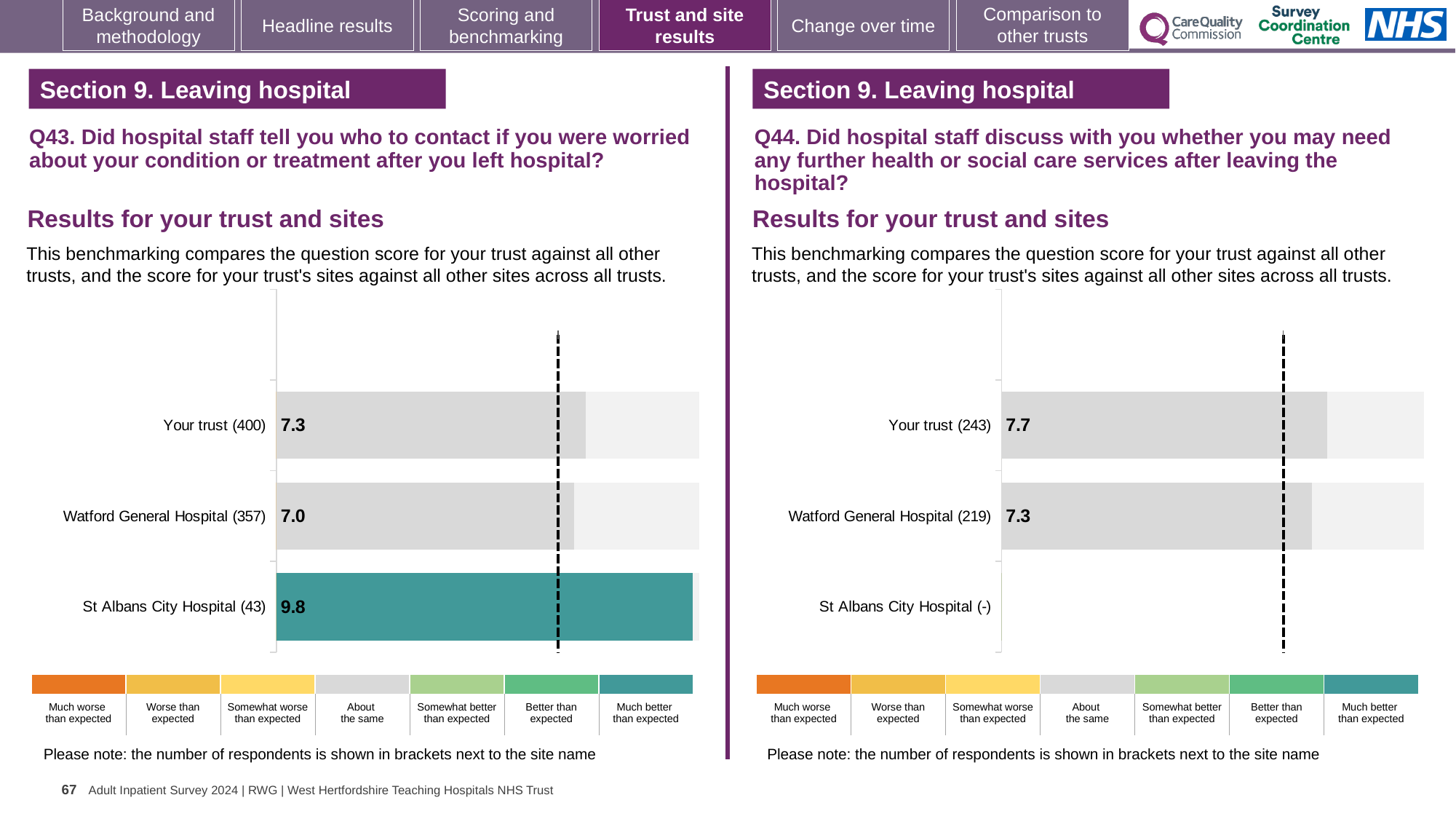
In the Q44 chart on the right, what is the score for Your trust? 7.7 In the Q43 chart on the left, how many bars are plotted? 3 In the Q44 chart on the right, what is the score for Watford General Hospital? 7.3 In the Q43 chart on the left, what is the score for Your trust? 7.3 In the Q43 chart on the left, what is the difference between the St Albans City Hospital score and the Watford General Hospital score? 2.8 In the Q43 chart on the left, what is the score for St Albans City Hospital? 9.8 In the Q43 chart on the left, which site or trust has the highest score? St Albans City Hospital In the Q44 chart on the right, which is larger, the score for Your trust or the score for Watford General Hospital? Your trust In the Q43 chart on the left, what is the score for Watford General Hospital? 7.0 In the Q43 chart on the left, which site or trust has the lowest score? Watford General Hospital What type of chart is used in the Q43 chart on the left? Bar chart In the Q44 chart on the right, how many respondents are shown in brackets for Watford General Hospital? 219